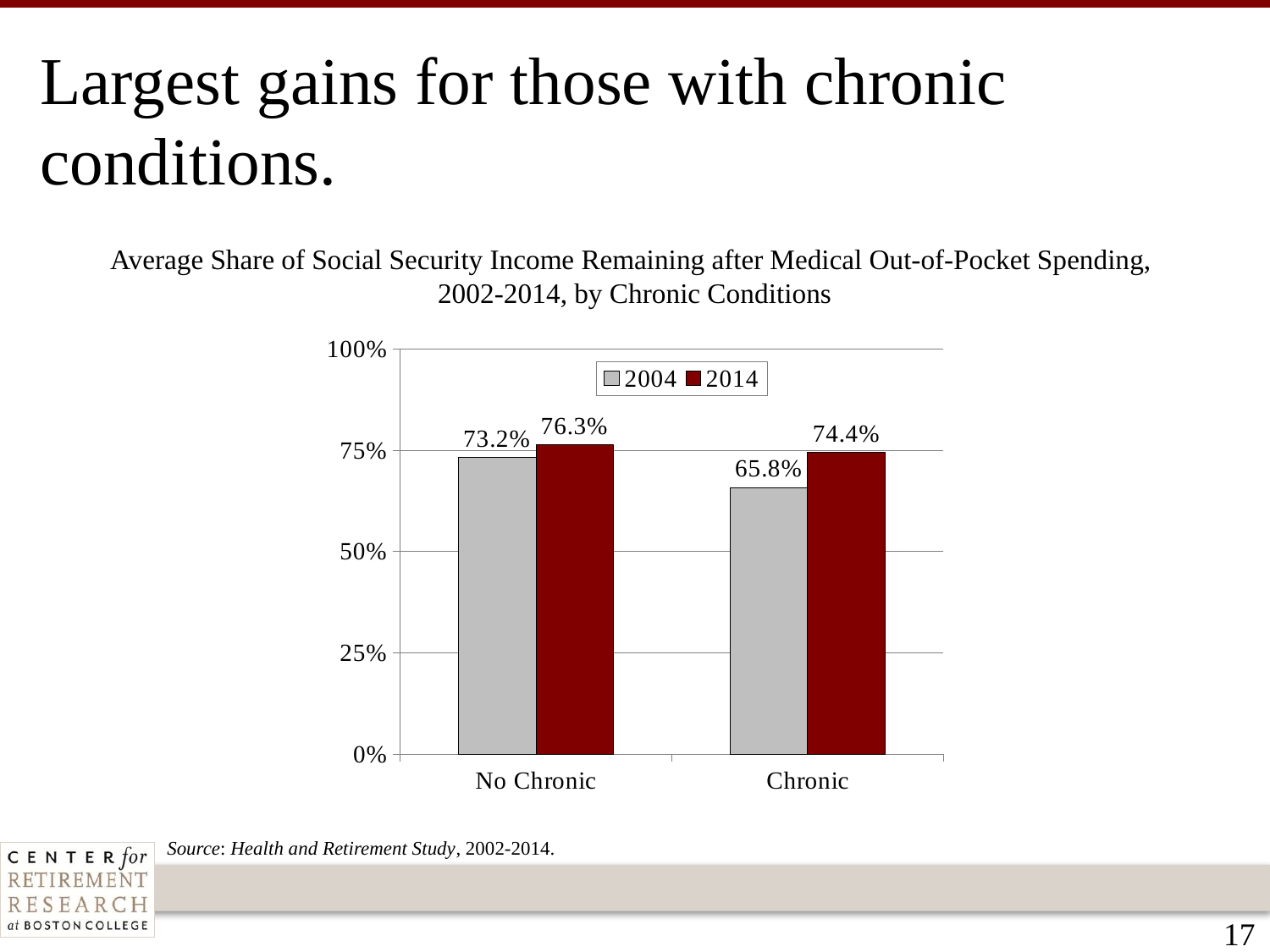
What kind of chart is shown on the slide? Bar chart How many categories are shown on the x axis? 2 Which category has the lowest 2004 value? Chronic What is the 2014 value for Chronic? 74.4% Which category has the highest 2014 value? No Chronic Which is larger, the 2004 value for No Chronic or the 2004 value for Chronic? No Chronic What is the difference between the 2014 and 2004 values for No Chronic? 3.1% How many series does the legend list? 2 What is the 2004 value for No Chronic? 73.2% What is the 2004 value for Chronic? 65.8% What is the difference between the 2014 and 2004 values for Chronic? 8.6% What is the 2014 value for No Chronic? 76.3%